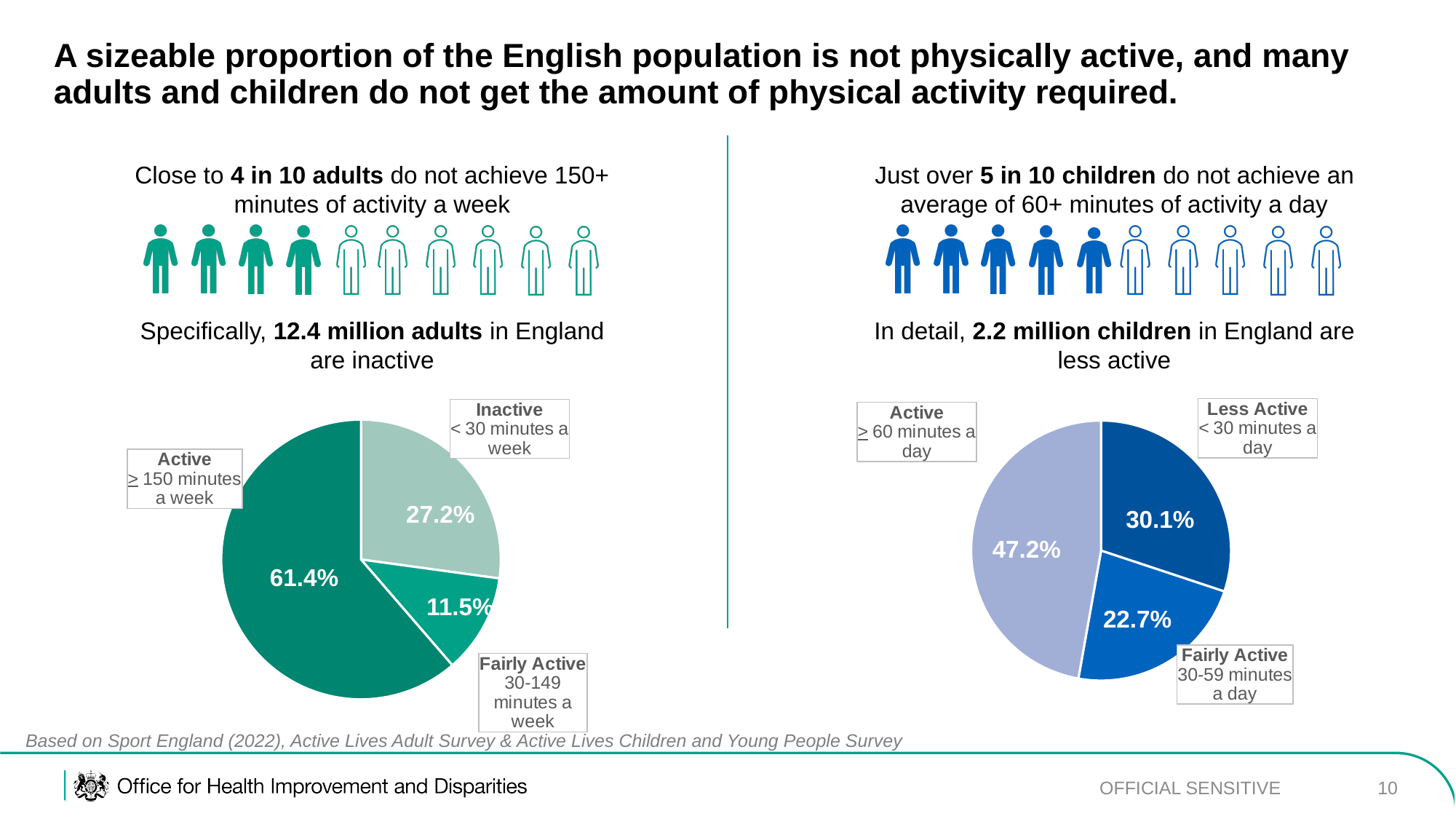
In the right pie chart (children), which category has the largest share? Active How many slices does the right pie chart (children) have? 3 What type of chart is used on the left side of the slide to show adult activity levels? Pie chart In the right pie chart (children), what percentage of children are Less Active (< 30 minutes a day)? 30.1% In the left pie chart (adults), what percentage of adults are Inactive (< 30 minutes a week)? 27.2% In the left pie chart (adults), what percentage of adults are Active (≥ 150 minutes a week)? 61.4% In the right pie chart (children), what percentage of children are Active (≥ 60 minutes a day)? 47.2% In the left pie chart (adults), what percentage of adults are Fairly Active (30-149 minutes a week)? 11.5% In the right pie chart (children), what percentage of children are Fairly Active (30-59 minutes a day)? 22.7% In the left pie chart (adults), which category has the smallest share? Fairly Active In the left pie chart (adults), what is the difference in percentage points between the Inactive and Fairly Active shares? 15.7 In the right pie chart (children), which is larger: the Less Active share or the Fairly Active share? Less Active